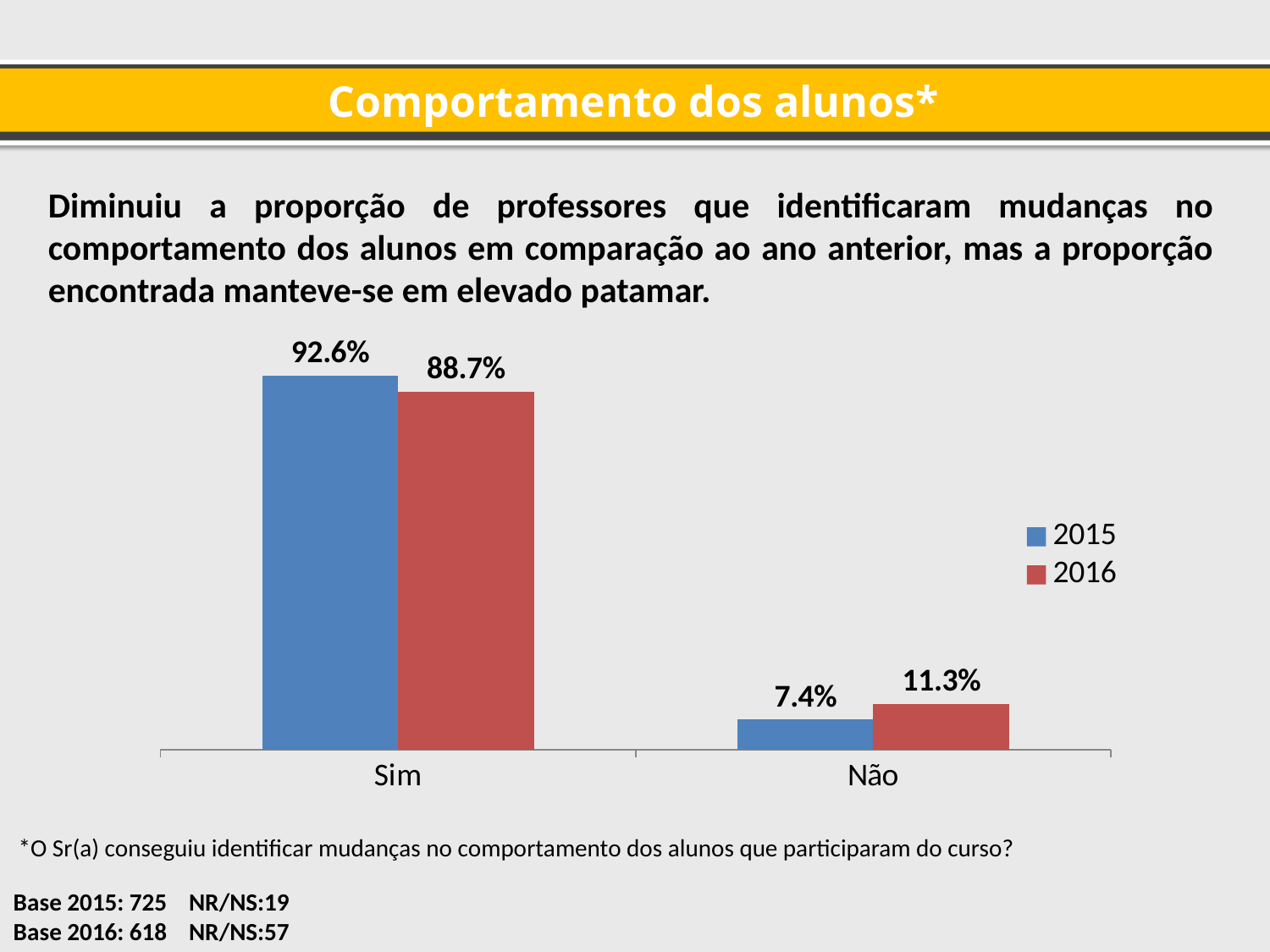
What is the difference between the 2016 and 2015 values in the "Não" category? 3.9% How many series does the legend list? 2 What is the value for 2016 in the "Sim" category? 88.7% What is the value for 2015 in the "Não" category? 7.4% What kind of chart is shown on the slide? Bar chart In the "Não" category, which series has the larger value, 2015 or 2016? 2016 Which category has the lowest value for the 2016 series? Não What is the difference between the 2015 and 2016 values in the "Sim" category? 3.9% What is the value for 2015 in the "Sim" category? 92.6% How many categories are shown on the x axis? 2 Which category has the highest value for the 2015 series? Sim What is the value for 2016 in the "Não" category? 11.3%